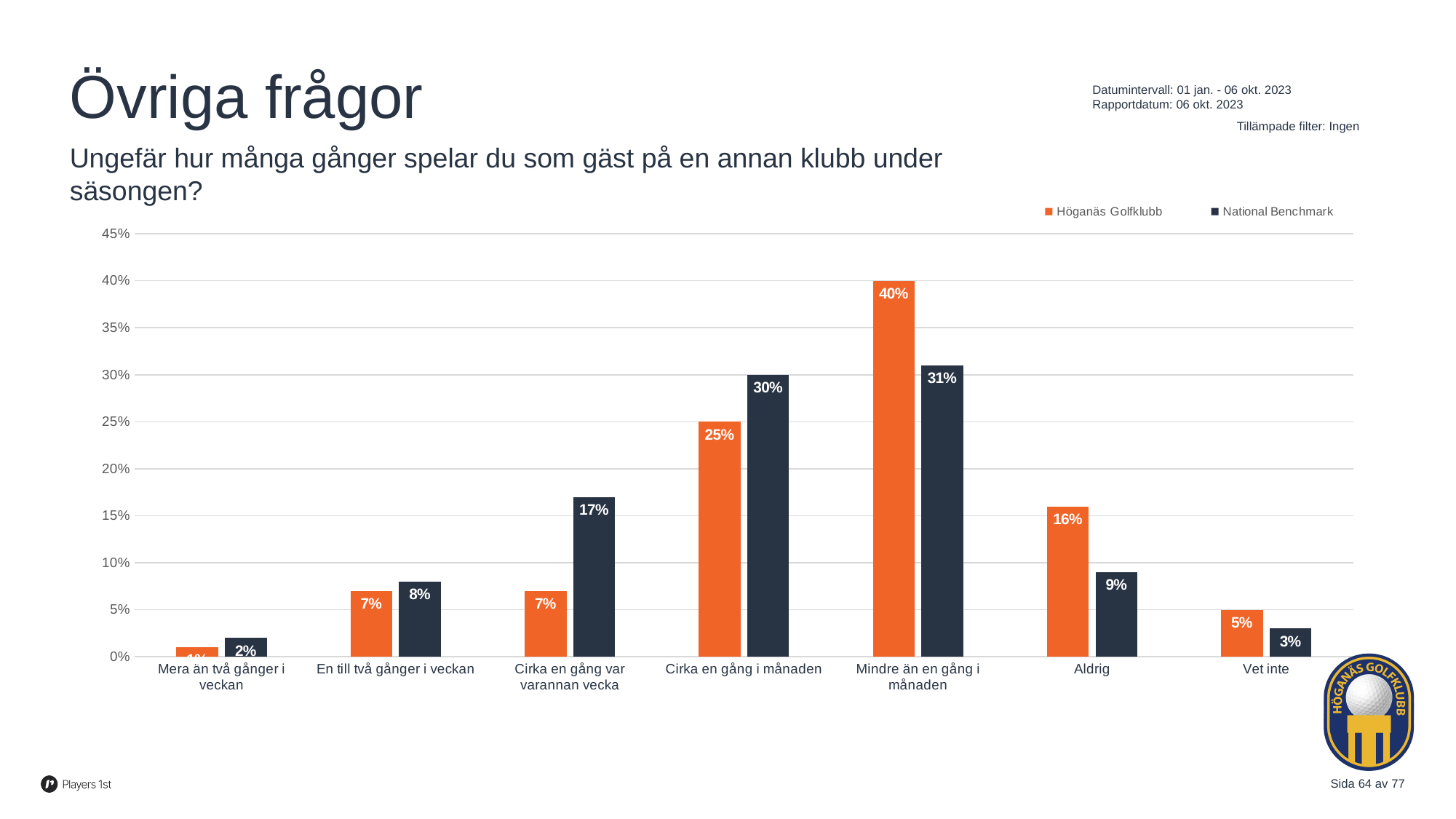
What kind of chart is shown on the slide? Bar chart What is the difference between the Höganäs Golfklubb and National Benchmark values for "Mindre än en gång i månaden"? 9% Which category has the highest Höganäs Golfklubb value? Mindre än en gång i månaden Which category has the lowest National Benchmark value? Mera än två gånger i veckan What is the National Benchmark value for "Vet inte"? 3% For "Cirka en gång i månaden", which is larger: Höganäs Golfklubb or National Benchmark? National Benchmark What is the Höganäs Golfklubb value for "Aldrig"? 16% What is the Höganäs Golfklubb value for "Mindre än en gång i månaden"? 40% Is the National Benchmark value for "Cirka en gång i månaden" greater or less than 25%? greater What is the National Benchmark value for "Cirka en gång var varannan vecka"? 17% How many series does the legend list? 2 How many categories are shown on the x axis? 7